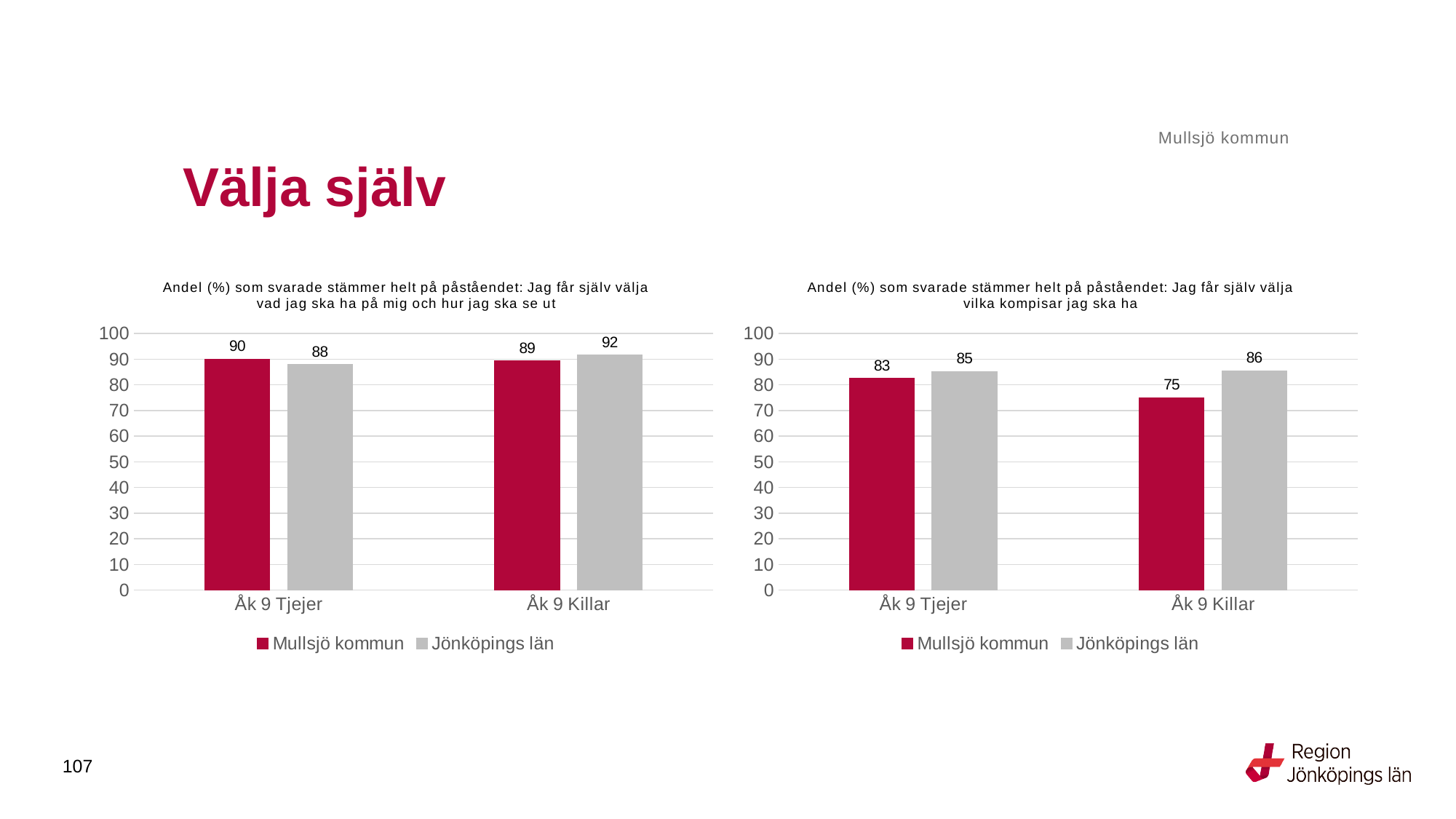
What kind of chart is the left chart? Bar chart In the left chart (about choosing what to wear and how to look), what is the difference between Mullsjö kommun and Jönköpings län for Åk 9 Tjejer? 2 In the left chart (about choosing what to wear and how to look), what is the value for Mullsjö kommun for Åk 9 Tjejer? 90 In the right chart (about choosing which friends to have), what is the value for Mullsjö kommun for Åk 9 Killar? 75 In the right chart (about choosing which friends to have), what is the value for Jönköpings län for Åk 9 Tjejer? 85 In the left chart (about choosing what to wear and how to look), which bar has the highest value? Jönköpings län, Åk 9 Killar In the left chart (about choosing what to wear and how to look), what is the value for Jönköpings län for Åk 9 Killar? 92 In the right chart (about choosing which friends to have), which is larger for Åk 9 Tjejer: Mullsjö kommun or Jönköpings län? Jönköpings län In the right chart (about choosing which friends to have), what is the difference between Jönköpings län and Mullsjö kommun for Åk 9 Killar? 11 How many categories are shown on the x axis of the right chart? 2 How many series does the legend of the left chart list? 2 In the right chart (about choosing which friends to have), which bar has the lowest value? Mullsjö kommun, Åk 9 Killar